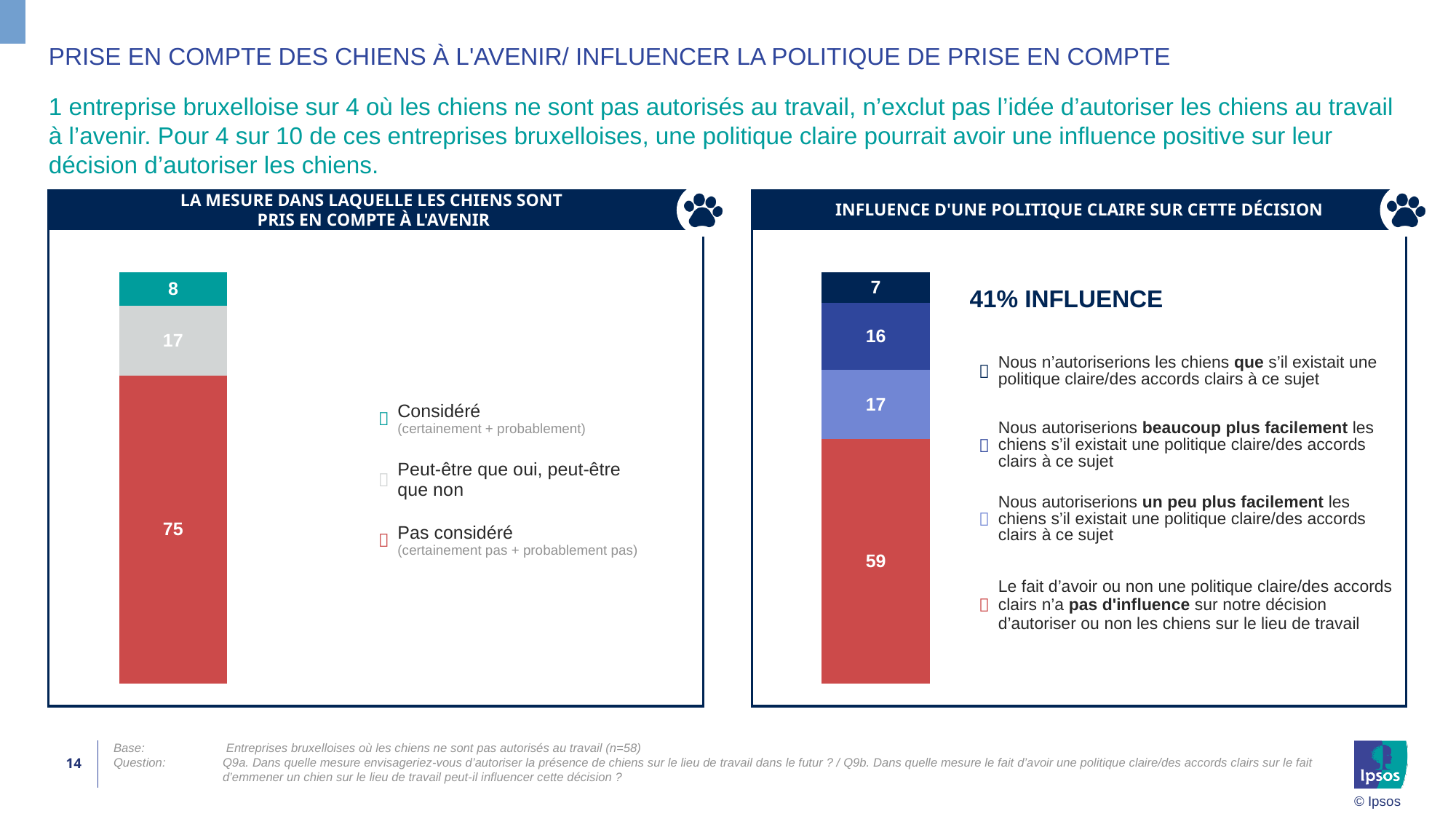
In the chart 'LA MESURE DANS LAQUELLE LES CHIENS SONT PRIS EN COMPTE À L'AVENIR', what is the value for 'Considéré'? 8 In the chart 'LA MESURE DANS LAQUELLE LES CHIENS SONT PRIS EN COMPTE À L'AVENIR', what is the value for 'Peut-être que oui, peut-être que non'? 17 In the chart 'INFLUENCE D'UNE POLITIQUE CLAIRE SUR CETTE DÉCISION', how many segments make up the stacked bar? 4 In the chart 'LA MESURE DANS LAQUELLE LES CHIENS SONT PRIS EN COMPTE À L'AVENIR', which segment is the largest? Pas considéré What type of chart is shown on the left of the slide? Stacked bar chart In the chart 'LA MESURE DANS LAQUELLE LES CHIENS SONT PRIS EN COMPTE À L'AVENIR', what is the difference between 'Pas considéré' and 'Considéré'? 67 In the chart 'INFLUENCE D'UNE POLITIQUE CLAIRE SUR CETTE DÉCISION', which segment is the smallest? Nous n'autoriserions les chiens que s'il existait une politique claire (7) In the chart 'INFLUENCE D'UNE POLITIQUE CLAIRE SUR CETTE DÉCISION', what is the value for 'pas d'influence'? 59 In the chart 'INFLUENCE D'UNE POLITIQUE CLAIRE SUR CETTE DÉCISION', what is the value for 'Nous autoriserions beaucoup plus facilement les chiens'? 16 In the chart 'LA MESURE DANS LAQUELLE LES CHIENS SONT PRIS EN COMPTE À L'AVENIR', how many segments make up the stacked bar? 3 In the chart 'LA MESURE DANS LAQUELLE LES CHIENS SONT PRIS EN COMPTE À L'AVENIR', what is the value for 'Pas considéré'? 75 In the chart 'INFLUENCE D'UNE POLITIQUE CLAIRE SUR CETTE DÉCISION', what is the total of the stacked bar? 99